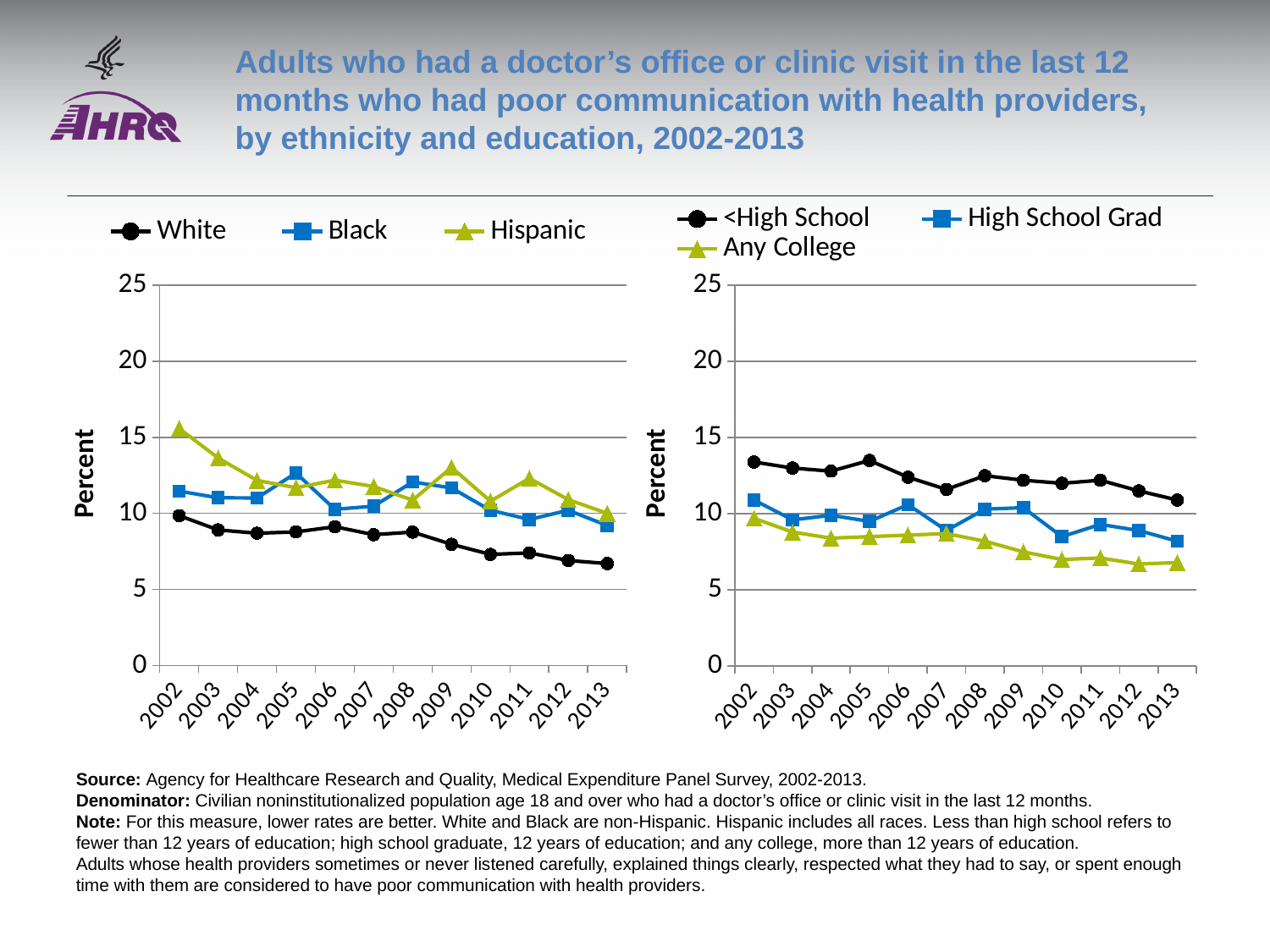
In the left chart (by ethnicity), which series has the highest value in 2002? Hispanic In the left chart (by ethnicity), which series has the lowest value in 2013? White In the right chart (by education), which series has the lowest value in 2013? Any College How many years are shown on the x axis of the left chart (by ethnicity)? 12 How many series does the legend of the right chart (by education) list? 3 In the right chart (by education), does the <High School series rise or fall from 2002 to 2013? fall In the right chart (by education), which is larger in 2005: <High School or Any College? <High School In the right chart (by education), is the value for <High School in 2002 greater or less than 10? greater What kind of chart is the left chart (by ethnicity)? line chart In the left chart (by ethnicity), is the value for White in 2013 greater or less than 10? less In the right chart (by education), which series has the highest values across all years? <High School In the left chart (by ethnicity), is the value for Hispanic in 2002 greater or less than 10? greater